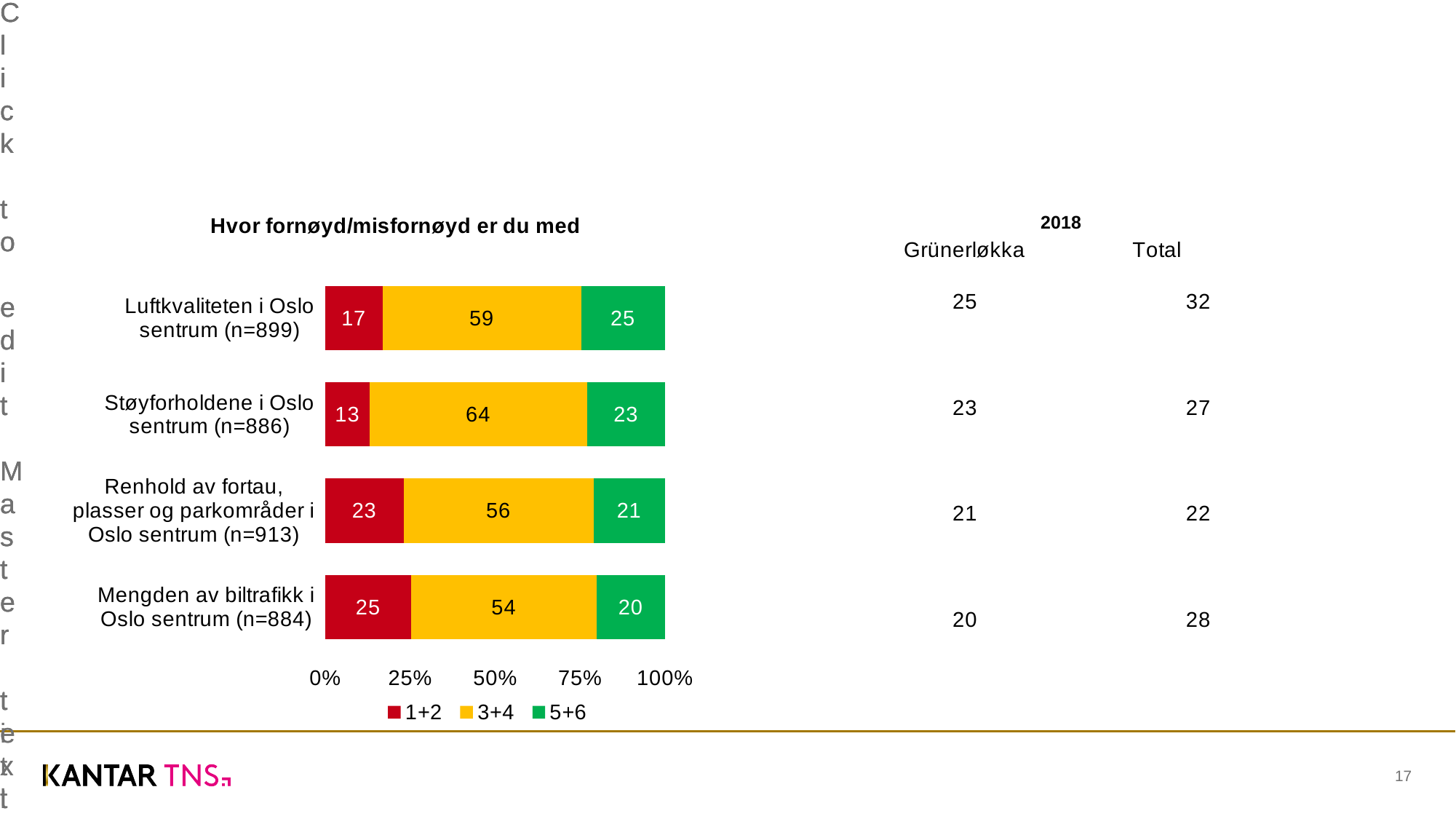
What type of chart is shown on the slide? Stacked bar chart Which category has the lowest 5+6 value? Mengden av biltrafikk i Oslo sentrum (n=884) What is the 5+6 value for 'Luftkvaliteten i Oslo sentrum (n=899)'? 25 What is the title of the chart? Hvor fornøyd/misfornøyd er du med How many categories are shown in the chart? 4 What is the total of the stacked bar for 'Renhold av fortau, plasser og parkområder i Oslo sentrum (n=913)'? 100 How many series does the chart legend list? 3 What is the 1+2 value for 'Mengden av biltrafikk i Oslo sentrum (n=884)'? 25 What is the difference between the 3+4 values for 'Støyforholdene i Oslo sentrum (n=886)' and 'Mengden av biltrafikk i Oslo sentrum (n=884)'? 10 What is the 3+4 value for 'Støyforholdene i Oslo sentrum (n=886)'? 64 Which is larger: the 1+2 value for 'Renhold av fortau, plasser og parkområder i Oslo sentrum (n=913)' or the 1+2 value for 'Luftkvaliteten i Oslo sentrum (n=899)'? Renhold av fortau, plasser og parkområder i Oslo sentrum (n=913) Which category has the highest 1+2 value? Mengden av biltrafikk i Oslo sentrum (n=884)